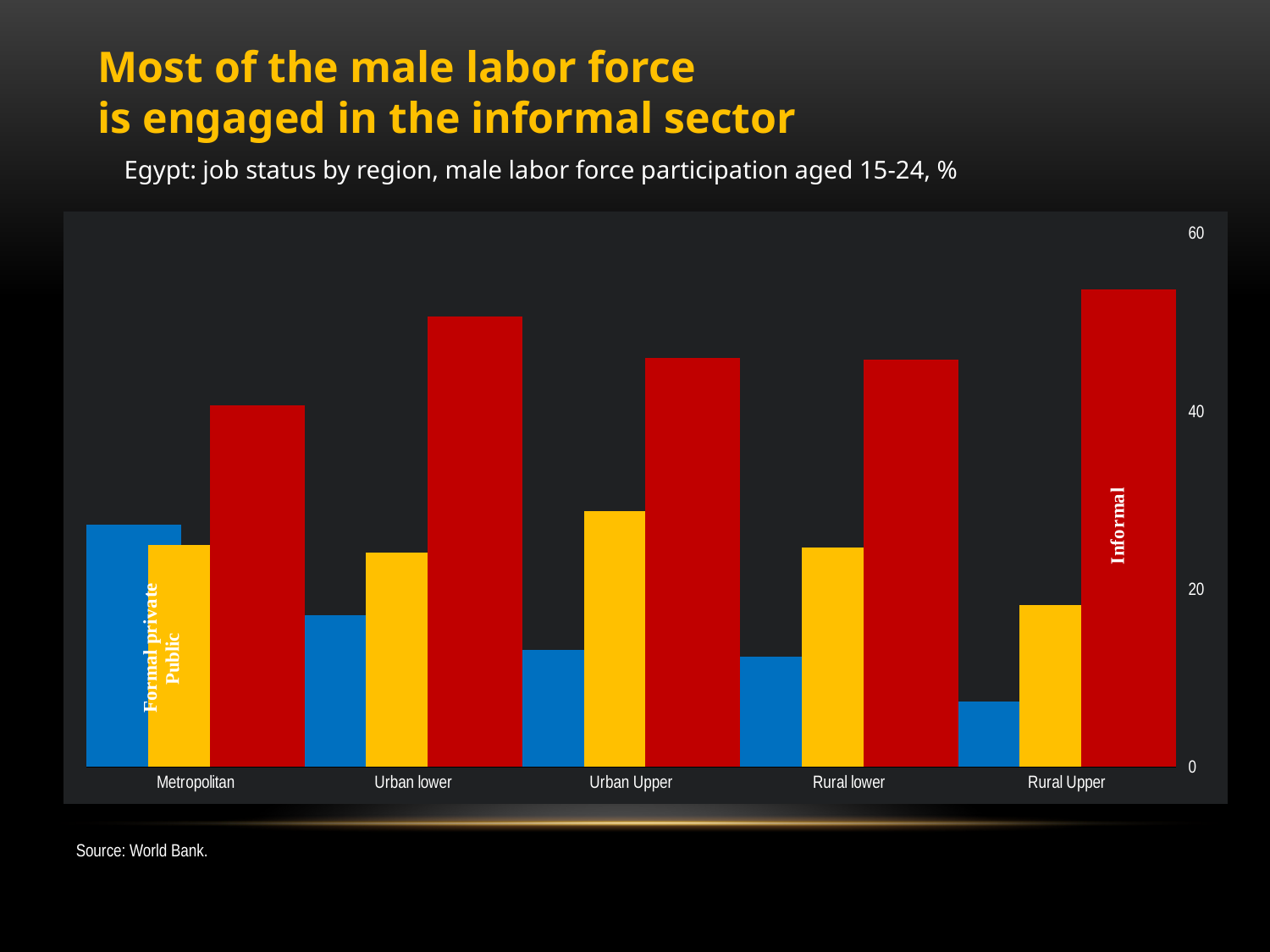
Is the Formal private value for Metropolitan greater or less than 20? greater Does the Formal private value rise or fall moving from Metropolitan to Rural Upper along the x axis? fall Is the Informal value for Urban lower greater or less than 40? greater Which region has the highest Formal private value? Metropolitan Which region has the lowest Informal value? Metropolitan How many regions are shown on the x axis of the chart? 5 Which region has the highest Informal value? Rural Upper What kind of chart is shown on the slide? bar chart For Urban lower, which is larger: the Public value or the Formal private value? Public Is the Formal private value for Rural Upper greater or less than 20? less Which region has the lowest Public value? Rural Upper How many job-status series does the chart show? 3